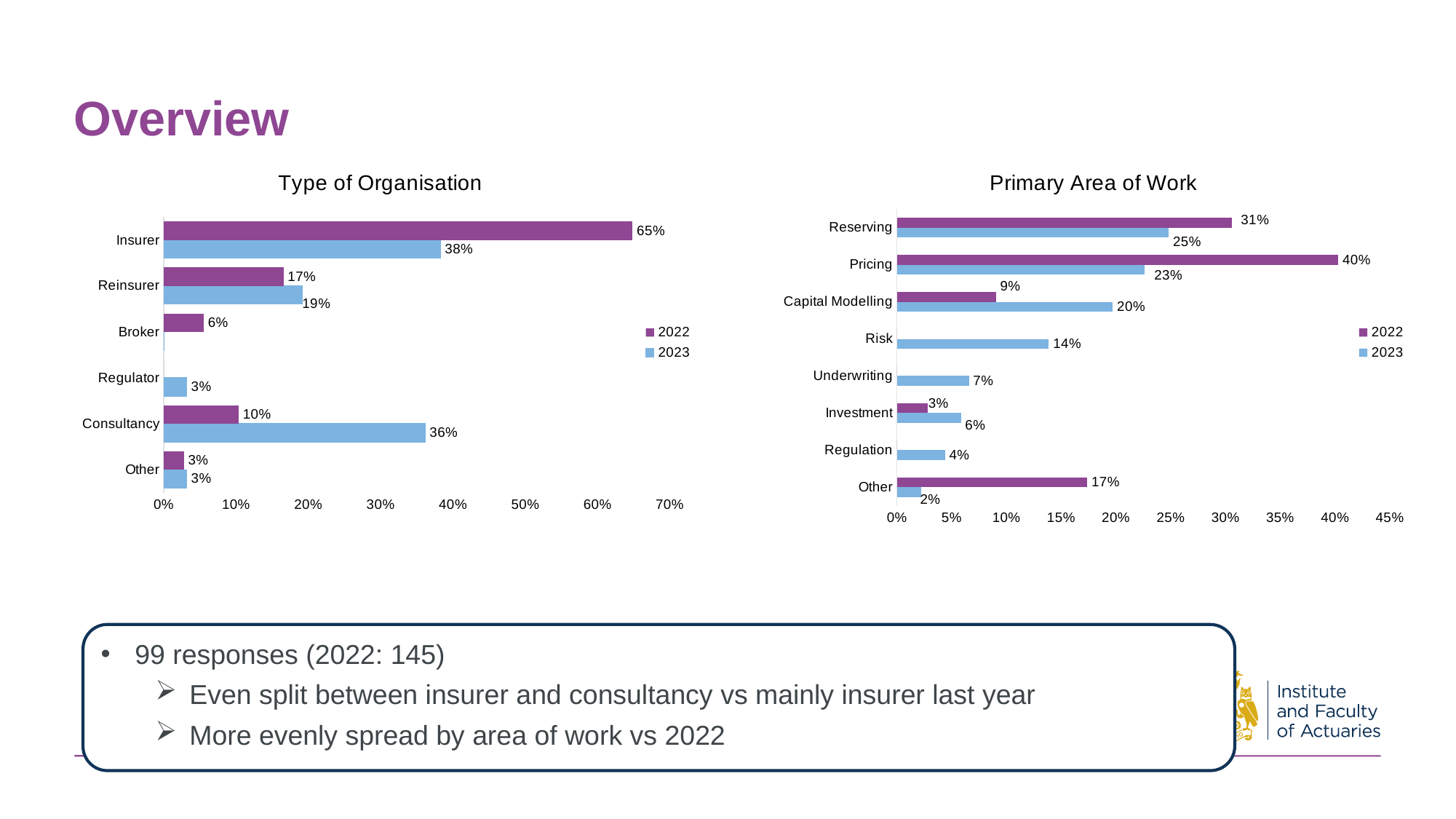
In the 'Type of Organisation' chart, which category has the highest 2023 value? Insurer In the 'Type of Organisation' chart, what is the 2023 value for Consultancy? 36% In the 'Primary Area of Work' chart, what is the 2023 value for Capital Modelling? 20% In the 'Primary Area of Work' chart, which category has the highest 2022 value? Pricing In the 'Type of Organisation' chart, what is the difference between the 2022 and 2023 values for Insurer? 27% In the 'Type of Organisation' chart, what is the 2022 value for Insurer? 65% What type of chart is the 'Primary Area of Work' chart? Bar chart In the 'Primary Area of Work' chart, what is the difference between the 2023 and 2022 values for Capital Modelling? 11% In the 'Type of Organisation' chart, how many categories are shown on the vertical axis? 6 In the 'Primary Area of Work' chart, what is the 2022 value for Pricing? 40% In the 'Type of Organisation' chart, how many series does the legend list? 2 In the 'Primary Area of Work' chart, which is larger for Reserving: the 2022 value or the 2023 value? 2022